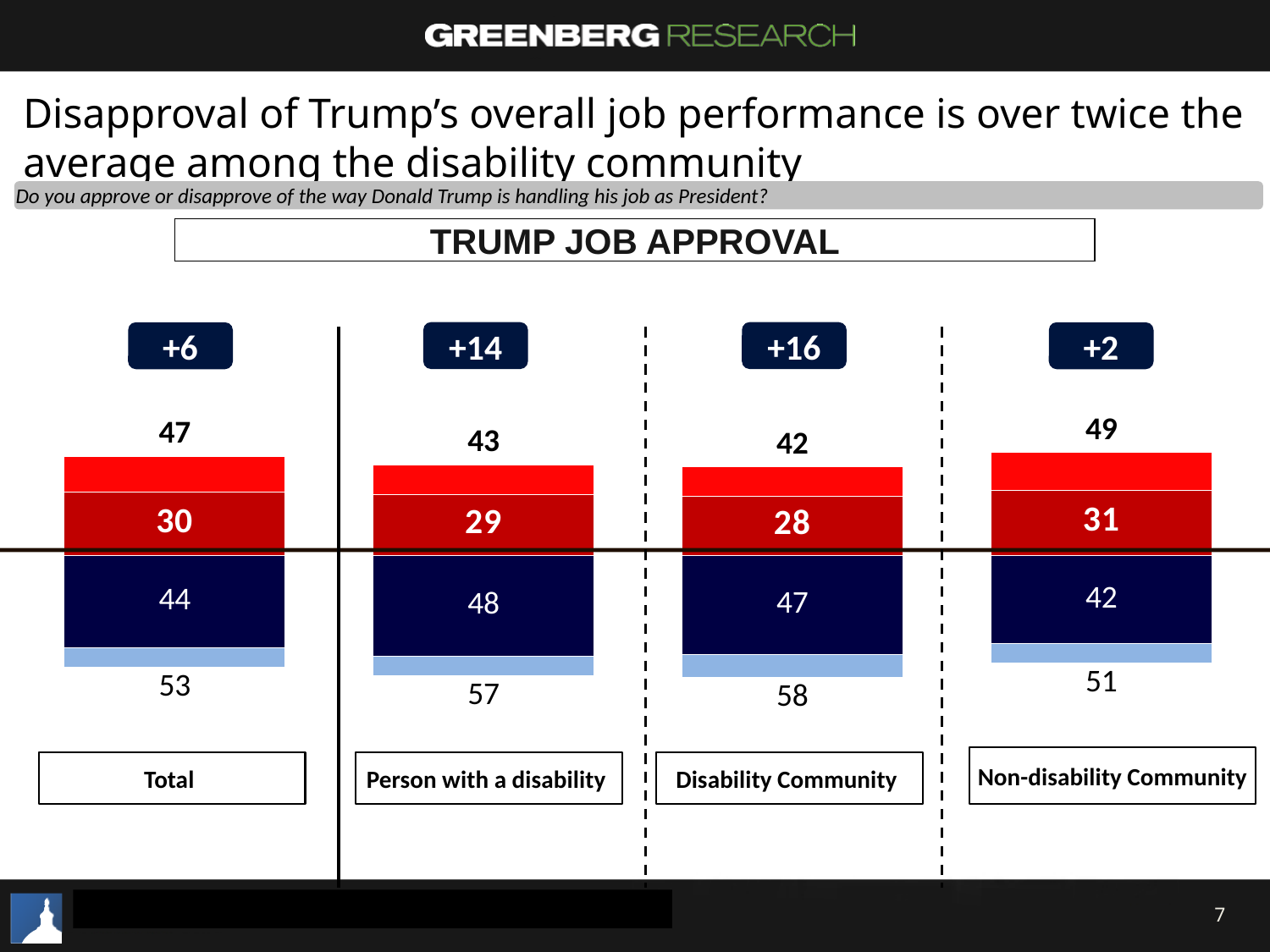
How many groups are shown in the chart? 4 Which group has the lowest value printed above its red bar? Disability Community What is the value printed below the dark blue bar for the Disability Community group? 58 What kind of chart is shown on the slide? Stacked bar chart What is the value printed inside the dark blue segment for the Person with a disability group? 48 What is the value printed above the red bar for the Total group? 47 What is the difference between the value below the dark blue bar for Person with a disability (57) and for Non-disability Community (51)? 6 Which group has the highest value printed below its dark blue bar? Disability Community Which is larger: the value above the red bar for Total or for Non-disability Community? Non-disability Community What net figure is shown in the box above the Disability Community group? +16 What is the value printed inside the dark red segment for the Non-disability Community group? 31 What is the title shown in the box above the chart? TRUMP JOB APPROVAL